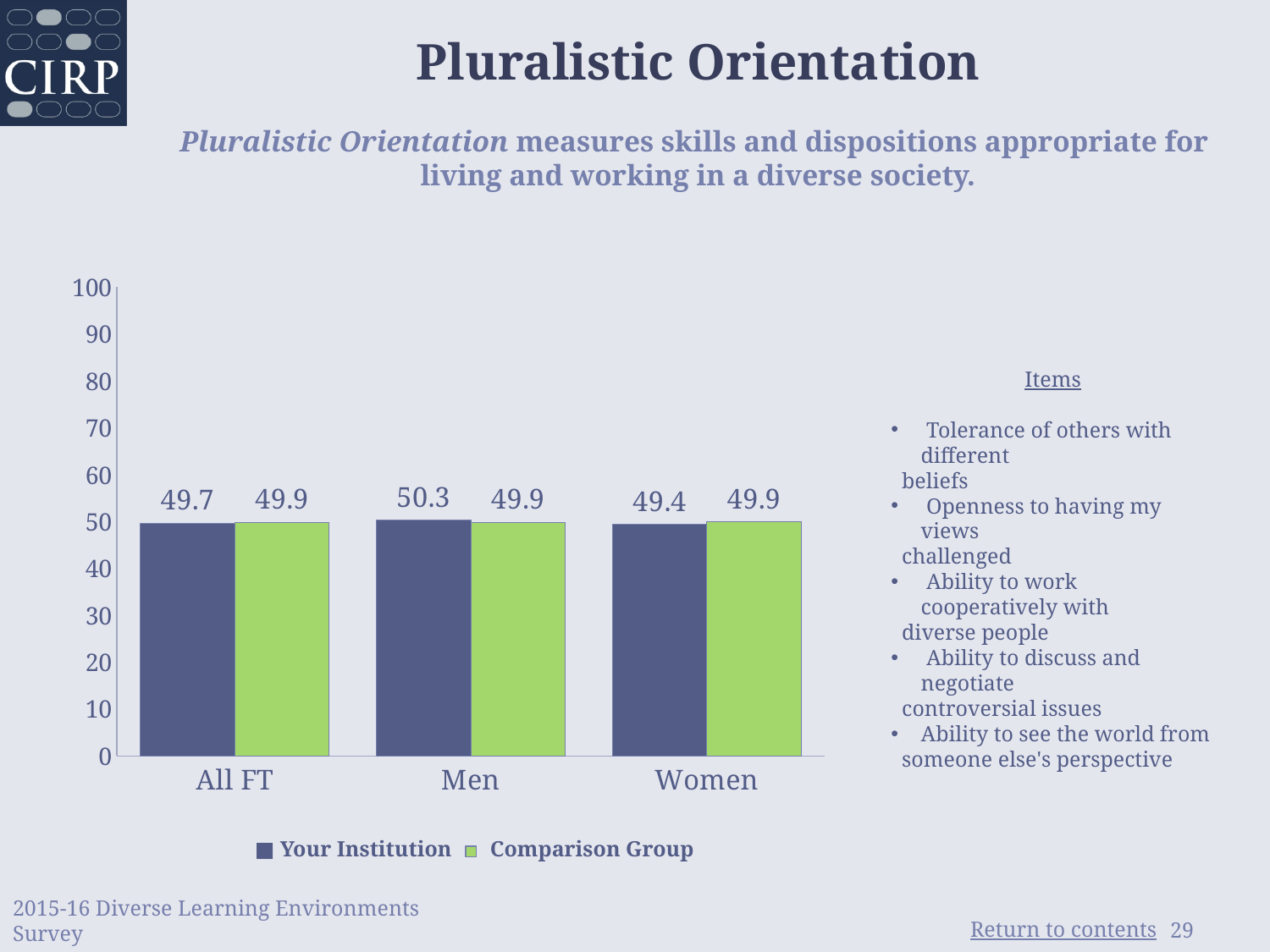
What is the difference between the Your Institution and Comparison Group values for Women? 0.5 What is the difference between the Your Institution values for Men and Women? 0.9 Is the value for Your Institution in the Women category greater or less than 60? less How many categories are shown on the x axis? 3 Based on the data labels, which is larger for Men: Your Institution or Comparison Group? Your Institution Which category has the highest value for Your Institution? Men Which category has the lowest value for Your Institution? Women What kind of chart is shown on the slide? bar chart What is the value for Your Institution in the Men category? 50.3 How many series does the legend list? 2 What is the value for the Comparison Group in the Women category? 49.9 What is the value for Your Institution in the All FT category? 49.7